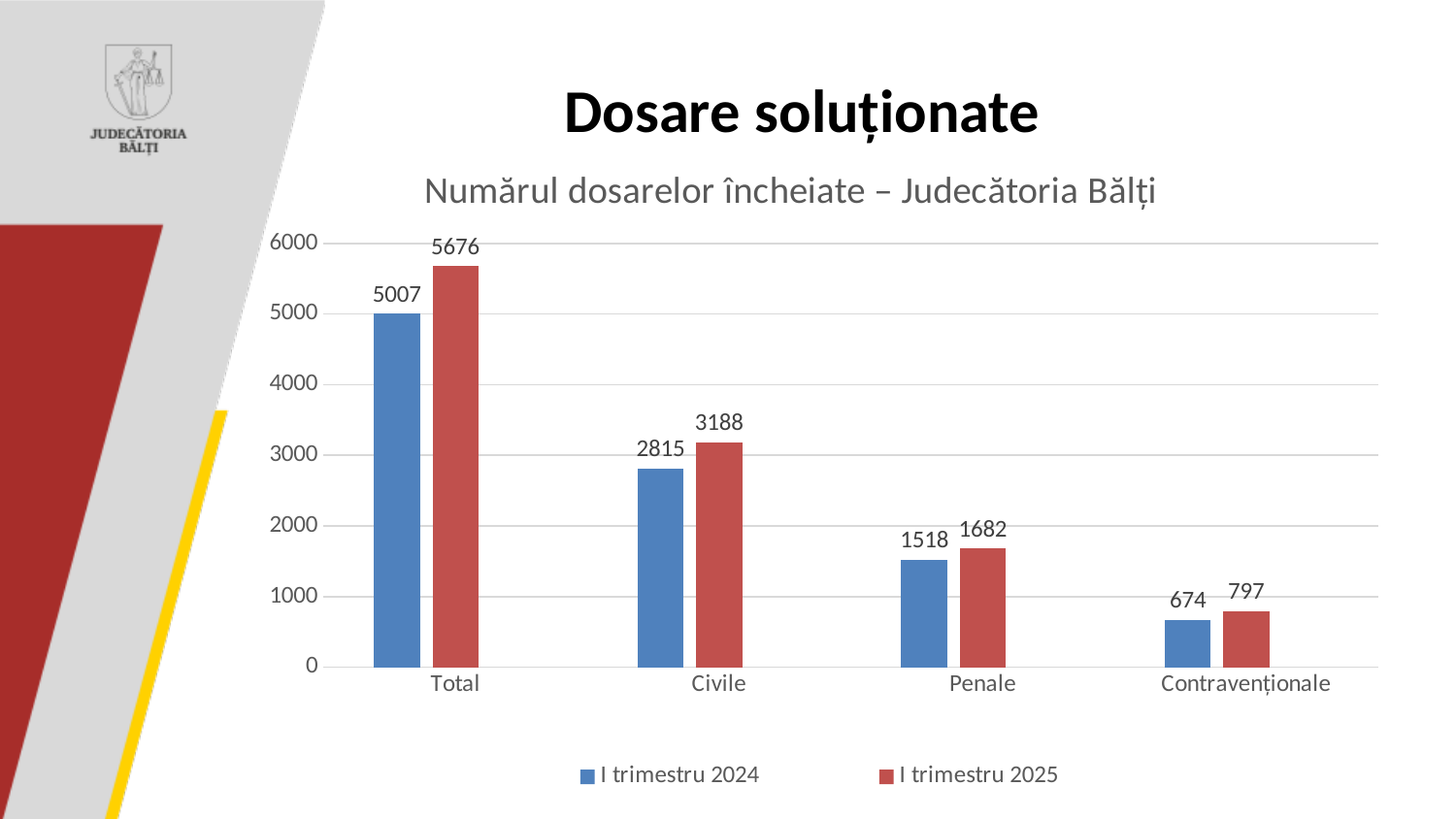
What is the value for Penale in the I trimestru 2024 series? 1518 Which category has the lowest value in the I trimestru 2024 series? Contravenționale What is the value for Civile in the I trimestru 2025 series? 3188 What is the difference between the I trimestru 2025 and I trimestru 2024 values for Civile? 373 What is the value for Contravenționale in the I trimestru 2025 series? 797 What is the title of the chart? Numărul dosarelor încheiate – Judecătoria Bălți Which category has the highest value in the I trimestru 2025 series? Total Which is larger for Penale: I trimestru 2024 or I trimestru 2025? I trimestru 2025 How many series does the legend list? 2 What kind of chart is shown on the slide? Bar chart What is the difference between the I trimestru 2025 and I trimestru 2024 values for Total? 669 How many categories are shown on the x axis? 4